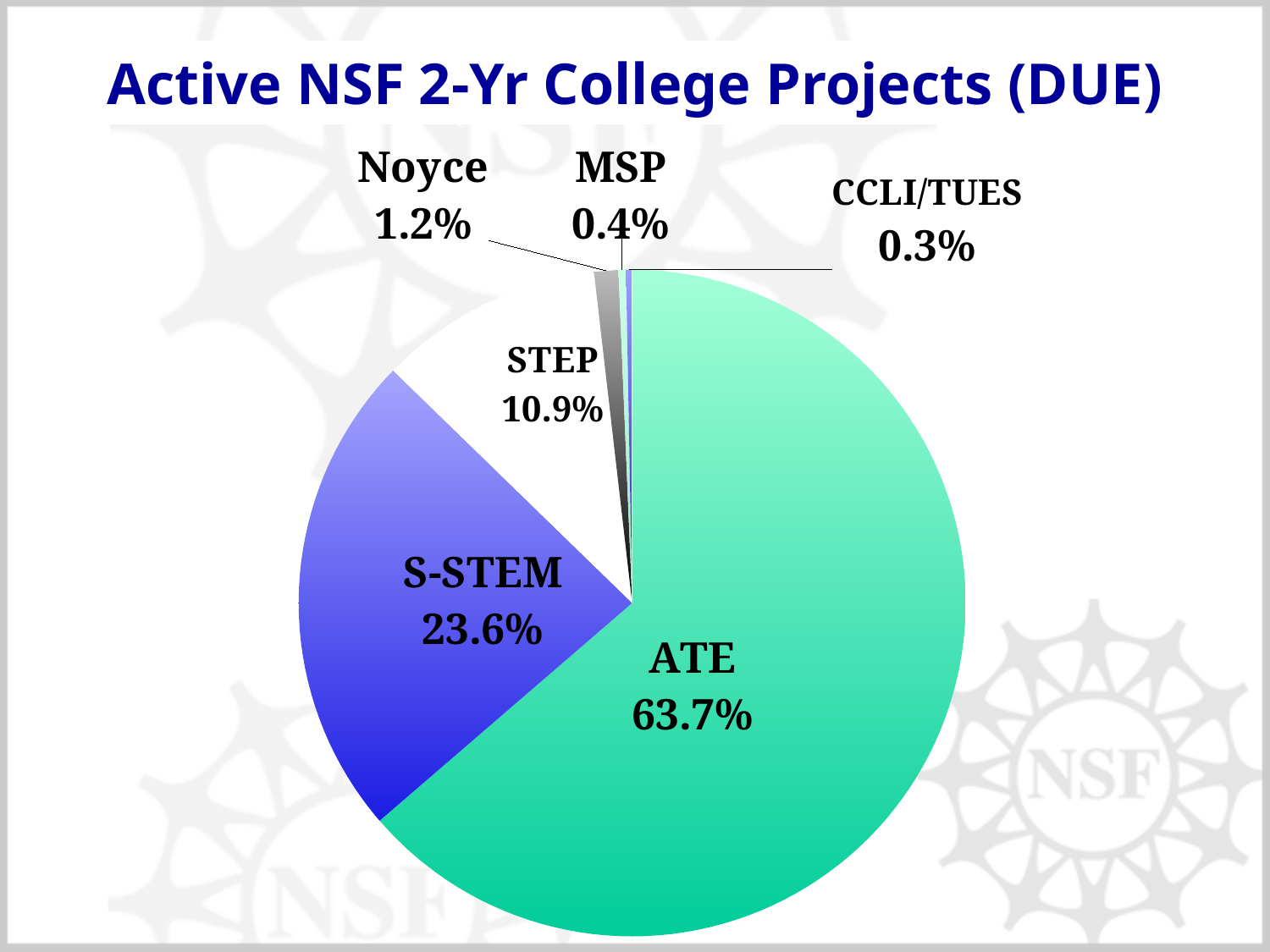
Which category has the largest slice of the pie? ATE What is the value shown for CCLI/TUES? 0.3% What is the value shown for S-STEM? 23.6% Which category has the smallest slice of the pie? CCLI/TUES What kind of chart is shown on the slide? Pie chart What share of the pie does ATE account for? 63.7% What is the value shown for Noyce? 1.2% Which is larger, STEP or S-STEM? S-STEM What is the value shown for STEP? 10.9% How many categories are shown in the pie chart? 6 What is the title of the chart? Active NSF 2-Yr College Projects (DUE) What is the difference in percentage points between ATE and S-STEM? 40.1